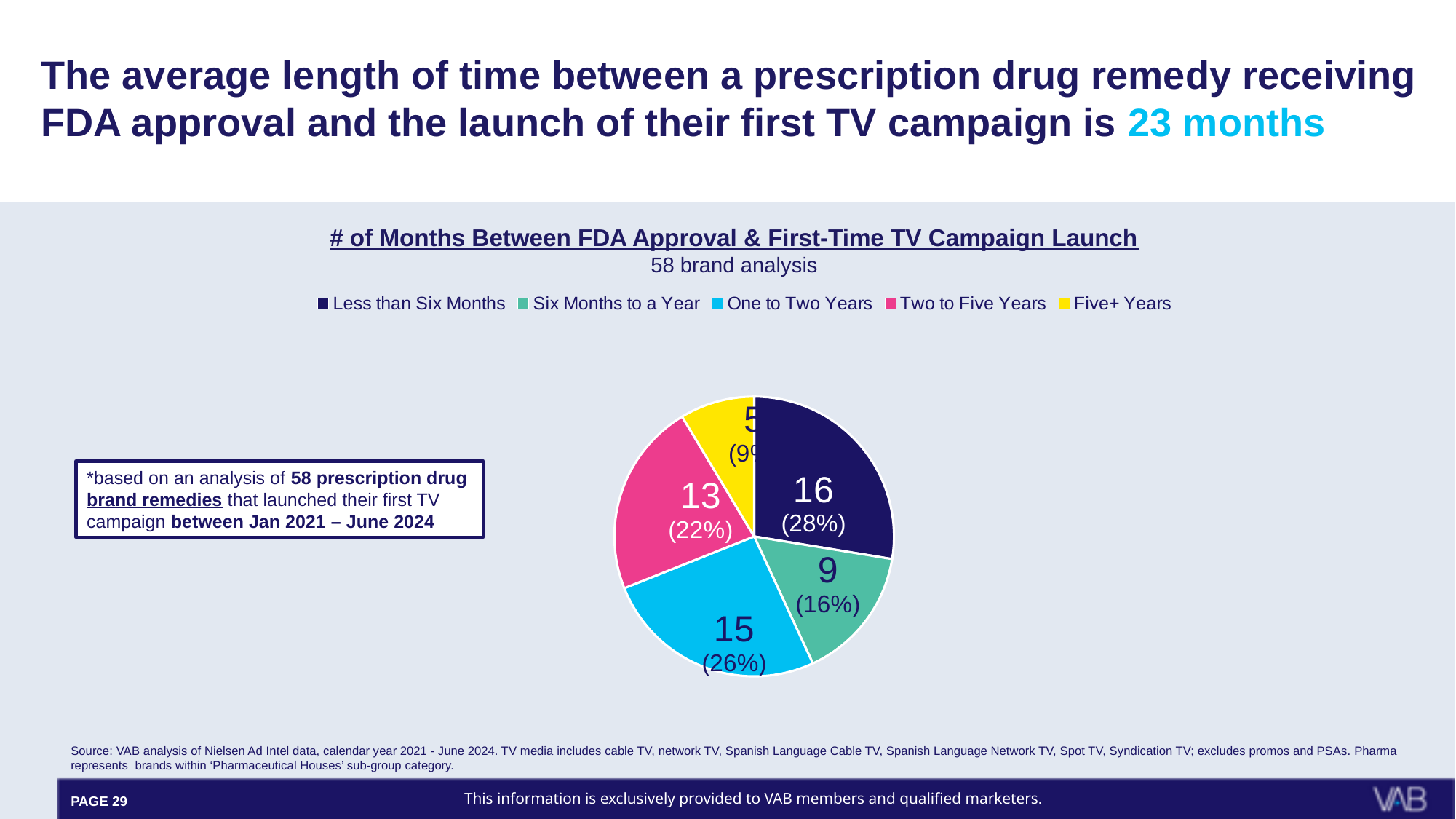
Which category has the smallest slice of the pie? Five+ Years What share of the pie does the Less than Six Months slice represent? 28% How many brands fall into the Less than Six Months category? 16 How many brands fall into the Six Months to a Year category? 9 What type of chart is shown on the slide? pie chart What is the difference in brand count between the Less than Six Months and Six Months to a Year categories? 7 Which category has the largest slice of the pie? Less than Six Months How many categories does the legend list? 5 Which category has more brands, One to Two Years or Two to Five Years? One to Two Years How many brands fall into the Two to Five Years category? 13 What share of the pie does the Two to Five Years slice represent? 22% How many brands fall into the One to Two Years category? 15